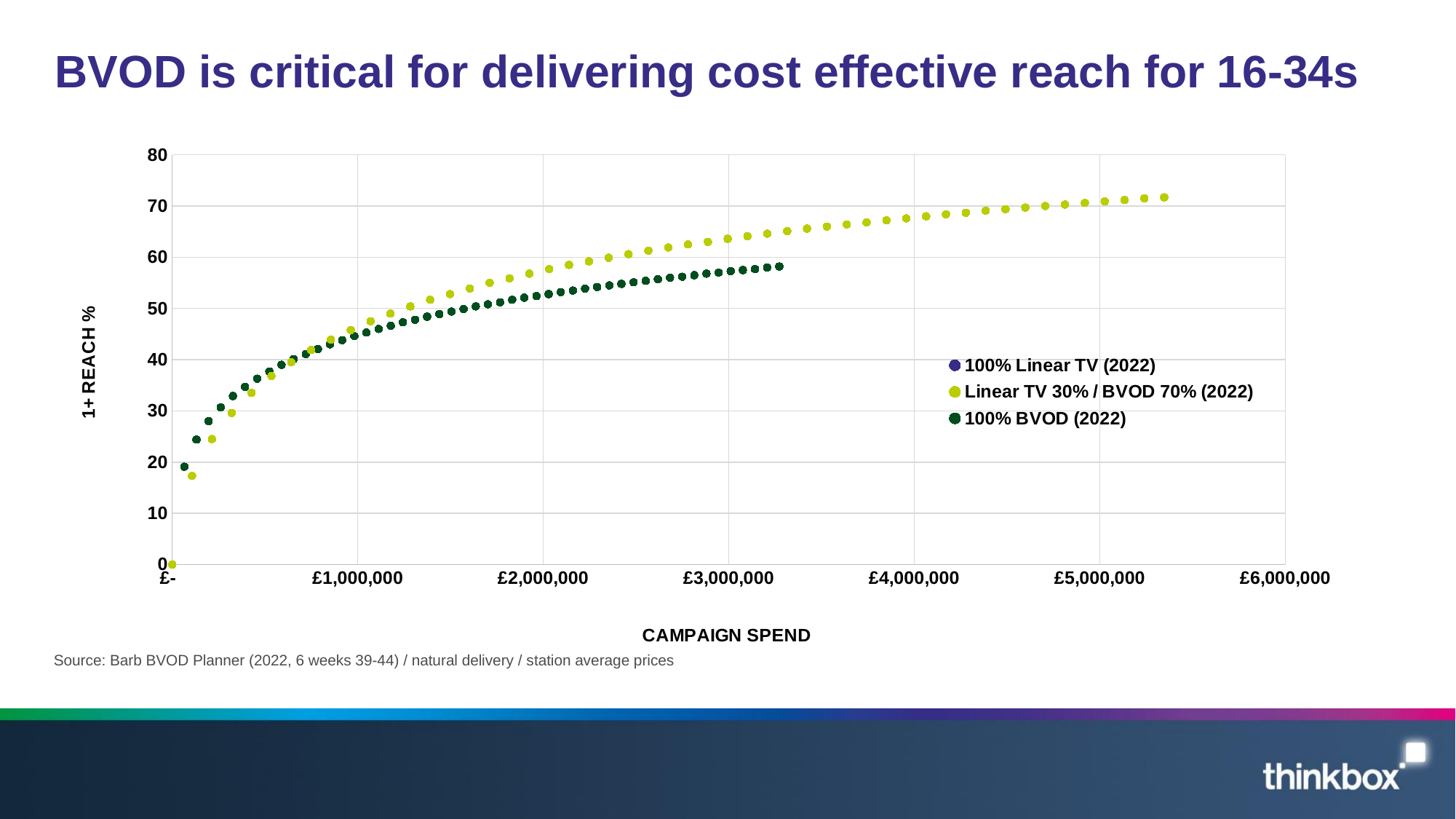
At a campaign spend of £3,000,000, is the 1+ reach % for the 100% BVOD (2022) series greater or less than 60? less At a campaign spend of £3,000,000, which series has the higher 1+ reach %: Linear TV 30% / BVOD 70% (2022) or 100% BVOD (2022)? Linear TV 30% / BVOD 70% (2022) Is the highest 1+ reach % reached by the Linear TV 30% / BVOD 70% (2022) series greater or less than 70? greater How many series does the legend list? 3 At a campaign spend of £3,000,000, is the 1+ reach % for the Linear TV 30% / BVOD 70% (2022) series greater or less than 60? greater What is the title of the chart's horizontal axis? CAMPAIGN SPEND Does 1+ reach % rise or fall as campaign spend increases? Rises Which plotted series extends to the highest campaign spend on the chart? Linear TV 30% / BVOD 70% (2022) What is the title of the chart's vertical axis? 1+ REACH % What kind of chart is shown on the slide? Scatter chart